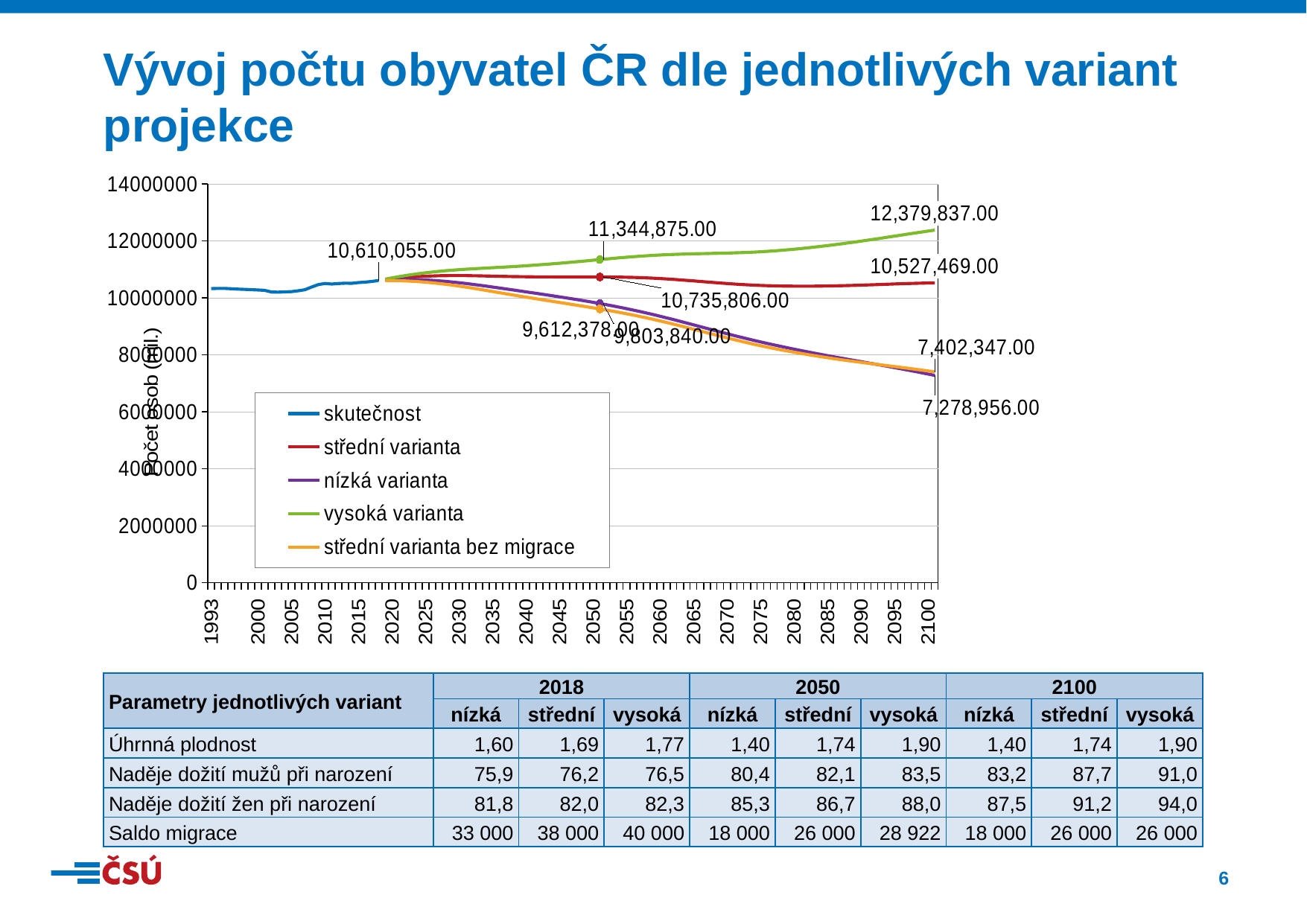
What kind of chart is shown on the slide? line chart Is the value of the nízká varianta series in 2100 greater or less than 8000000? less How many series does the chart legend list? 5 What is the difference between the labelled vysoká varianta and střední varianta values in 2100? 1,852,368.00 What value is labelled for the vysoká varianta series in 2050? 11,344,875.00 Which series has the highest value in 2100? vysoká varianta By how much does the labelled vysoká varianta value in 2100 exceed its labelled value in 2050? 1,034,962.00 Does the vysoká varianta series rise or fall between 2020 and 2100? rises What value is labelled for the střední varianta series in 2100? 10,527,469.00 What value is labelled for the vysoká varianta series in 2100? 12,379,837.00 What value is labelled at the end of the skutečnost series? 10,610,055.00 What value is labelled for the střední varianta series in 2050? 10,735,806.00